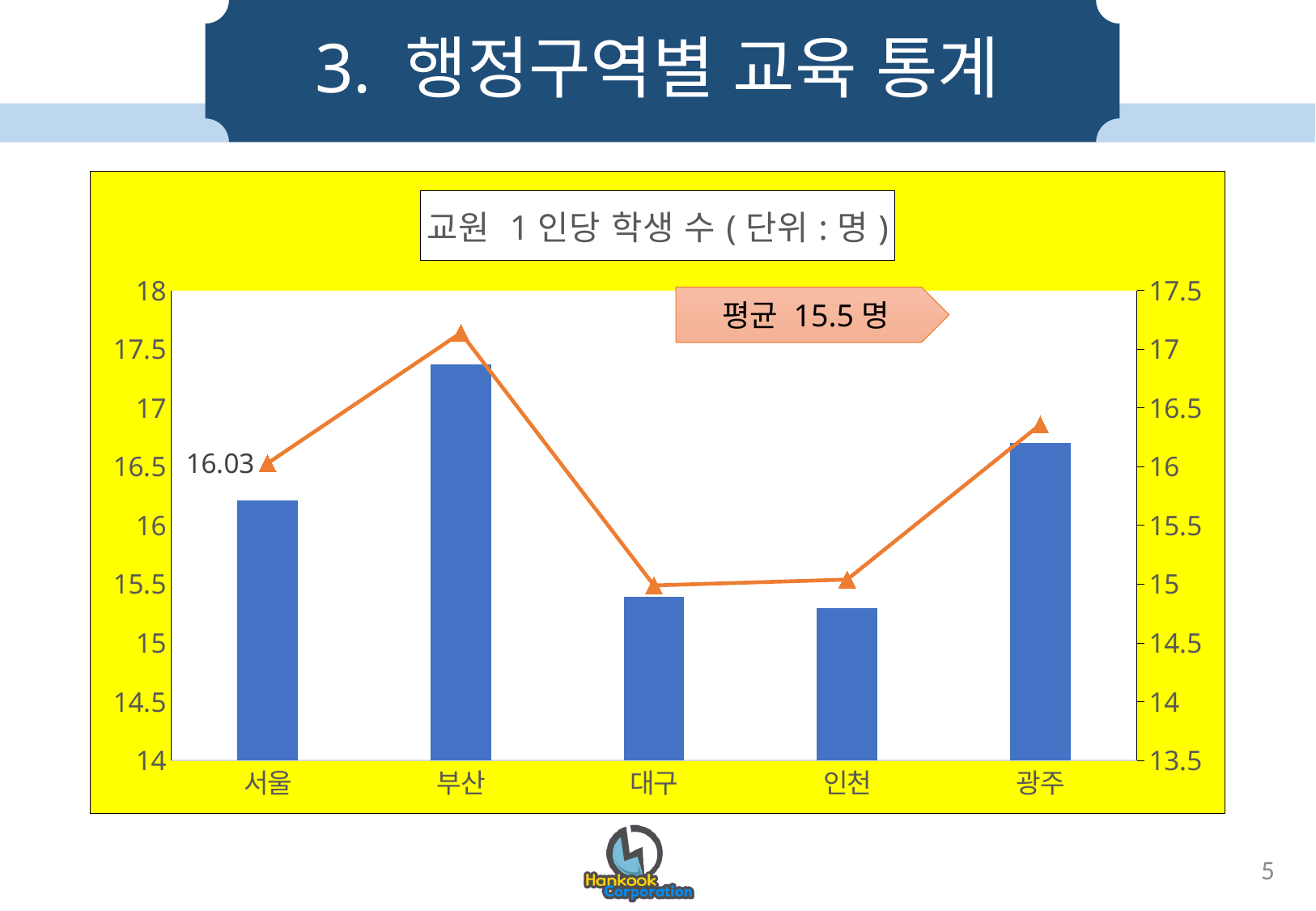
Is the bar value for 서울 greater or less than 16? greater Is the bar value for 대구 greater or less than 15.5? less Does the line rise or fall from 부산 to 대구? fall Which has the taller bar, 부산 or 광주? 부산 What is the title of the chart? 교원 1인당 학생 수 (단위 : 명) Is the bar value for 부산 greater or less than 17? greater What kind of chart is this? bar chart with a line Which category has the tallest bar? 부산 How many categories are shown on the x axis? 5 What is the data label shown on the line for 서울? 16.03 What average value is shown in the callout on the chart? 평균 15.5 명